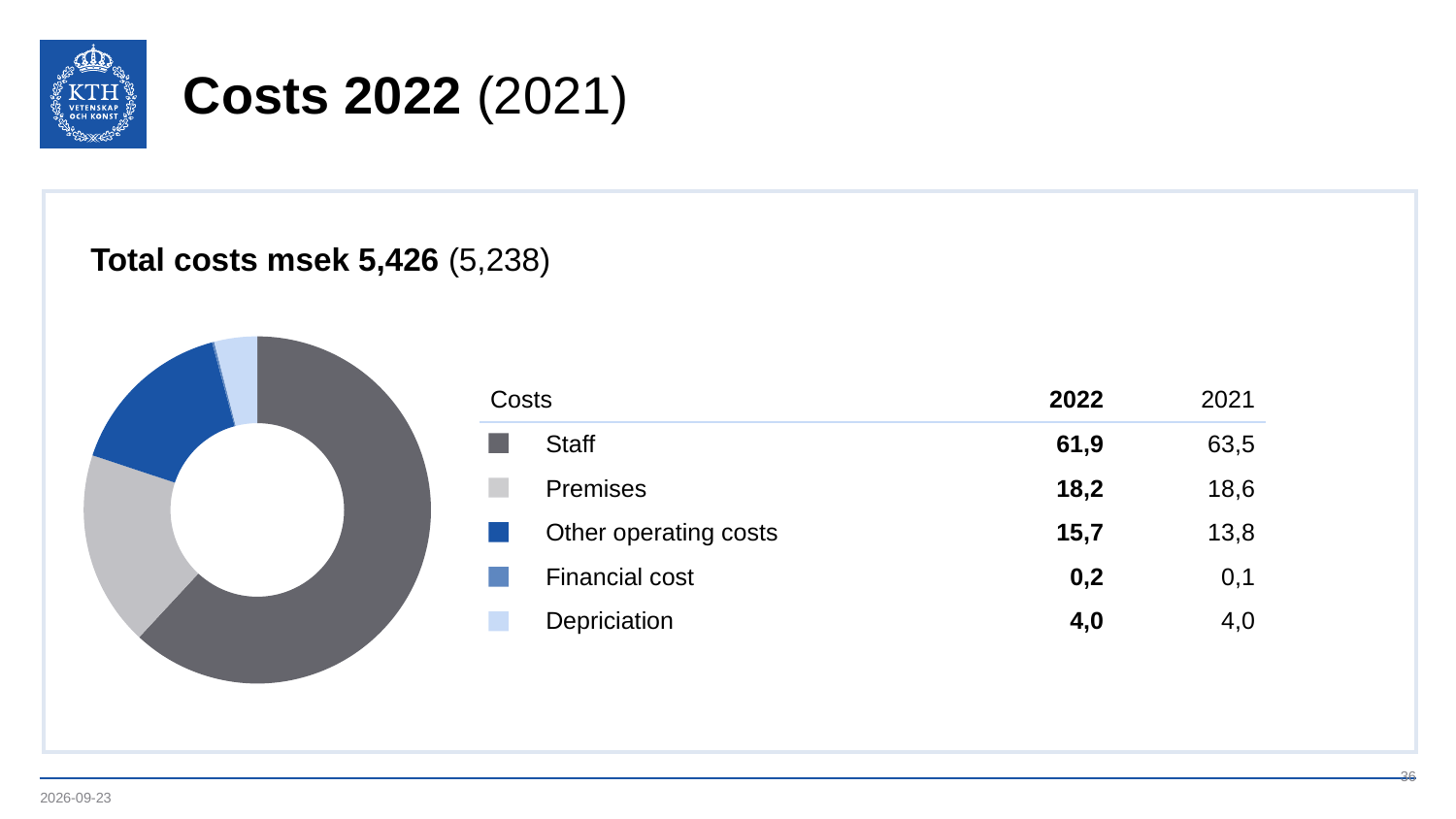
What is the 2021 value for Financial cost? 0,1 What is the 2022 value for Staff? 61,9 What is the 2022 value for Premises? 18,2 What is the 2022 value for Other operating costs? 15,7 Which is larger in 2022, Premises or Other operating costs? Premises How many cost categories does the chart show? 5 What kind of chart is shown on the slide? Pie (donut) chart What is the 2021 value for Depriciation? 4,0 What is the difference between the 2022 values for Staff and Premises? 43,7 Which cost category has the lowest 2022 value? Financial cost Which cost category has the highest 2022 value? Staff What total costs in msek are stated for 2022 above the chart? 5,426